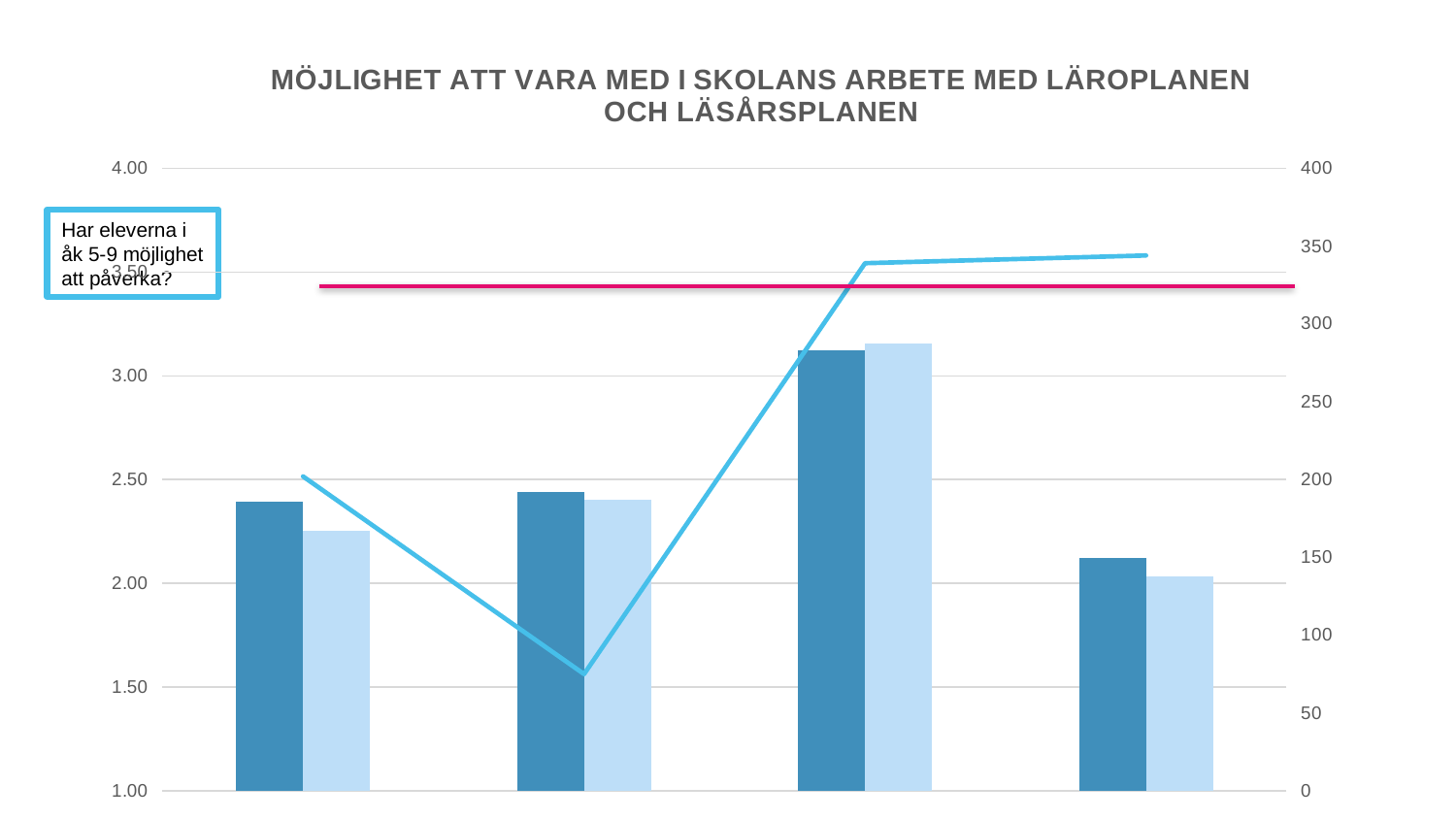
At which group, counted from the left, does the light blue line reach its lowest point? The second group Which group of bars, counted from the left, is the tallest? The third group Is the value of the light blue bar in the fourth group greater or less than 2.50 on the left axis? less How many groups of bars are plotted on the chart? 4 What is the title of the chart? MÖJLIGHET ATT VARA MED I SKOLANS ARBETE MED LÄROPLANEN OCH LÄSÅRSPLANEN Does the light blue line rise or fall between the second and third groups? rise What kind of chart is shown on the slide? A combined bar and line chart Which group of bars, counted from the left, is the shortest? The fourth group Are the bars in the third group taller or shorter than the bars in the first group? taller Is the value of the dark blue bar in the first group greater or less than 2.00 on the left axis? greater Is the value of the dark blue bar in the third group greater or less than 3.00 on the left axis? greater